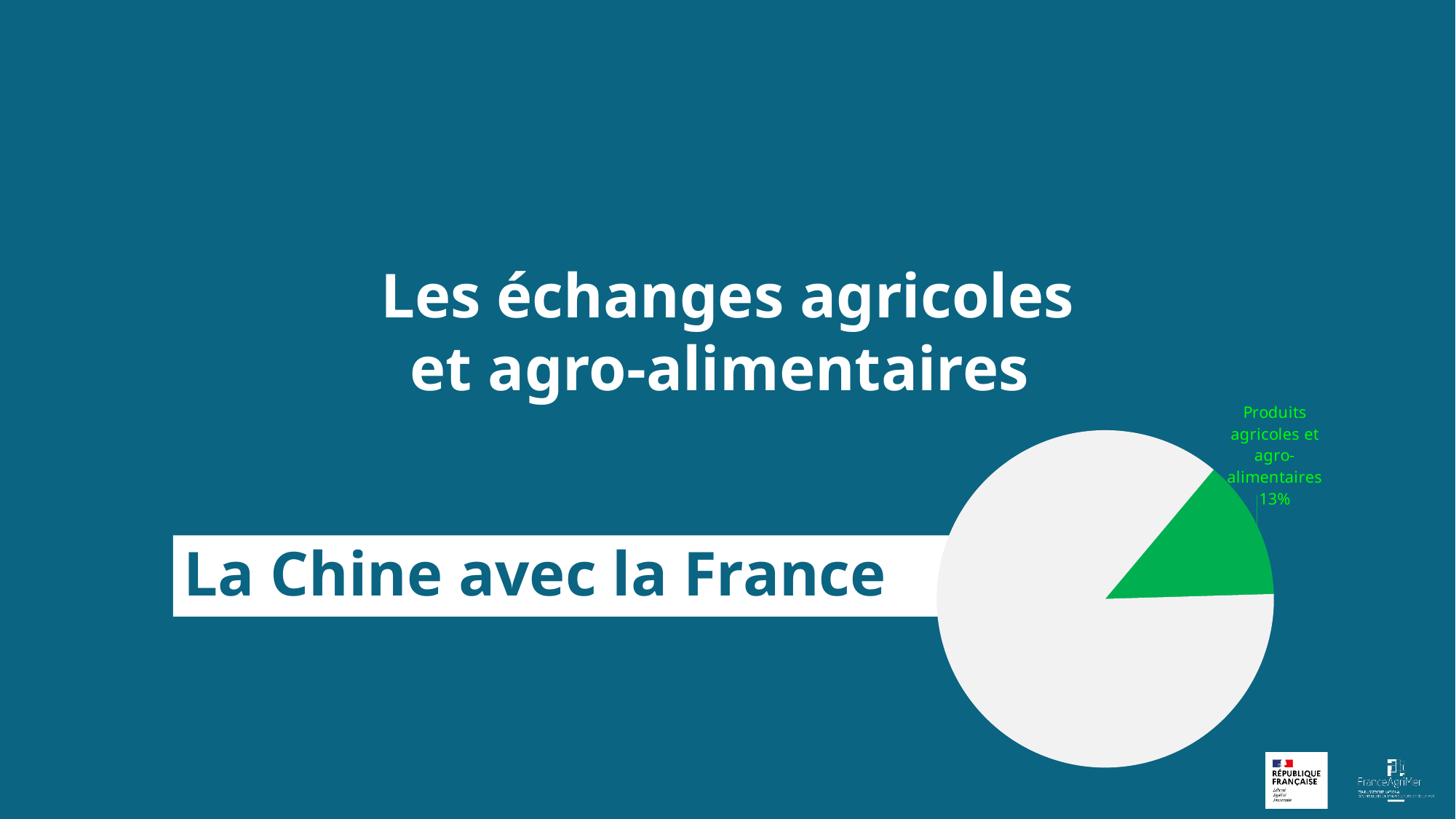
What share of the pie does the 'Produits agricoles et agro-alimentaires' slice represent? 13% Is the share of the 'Produits agricoles et agro-alimentaires' slice greater or less than 50%? less What colour is the 'Produits agricoles et agro-alimentaires' slice in the pie chart? green What kind of chart is shown on the slide? pie chart Which slice of the pie chart is labelled with a percentage? Produits agricoles et agro-alimentaires How many slices does the pie chart have? 2 Is the 'Produits agricoles et agro-alimentaires' slice the larger or the smaller of the two slices in the pie chart? smaller